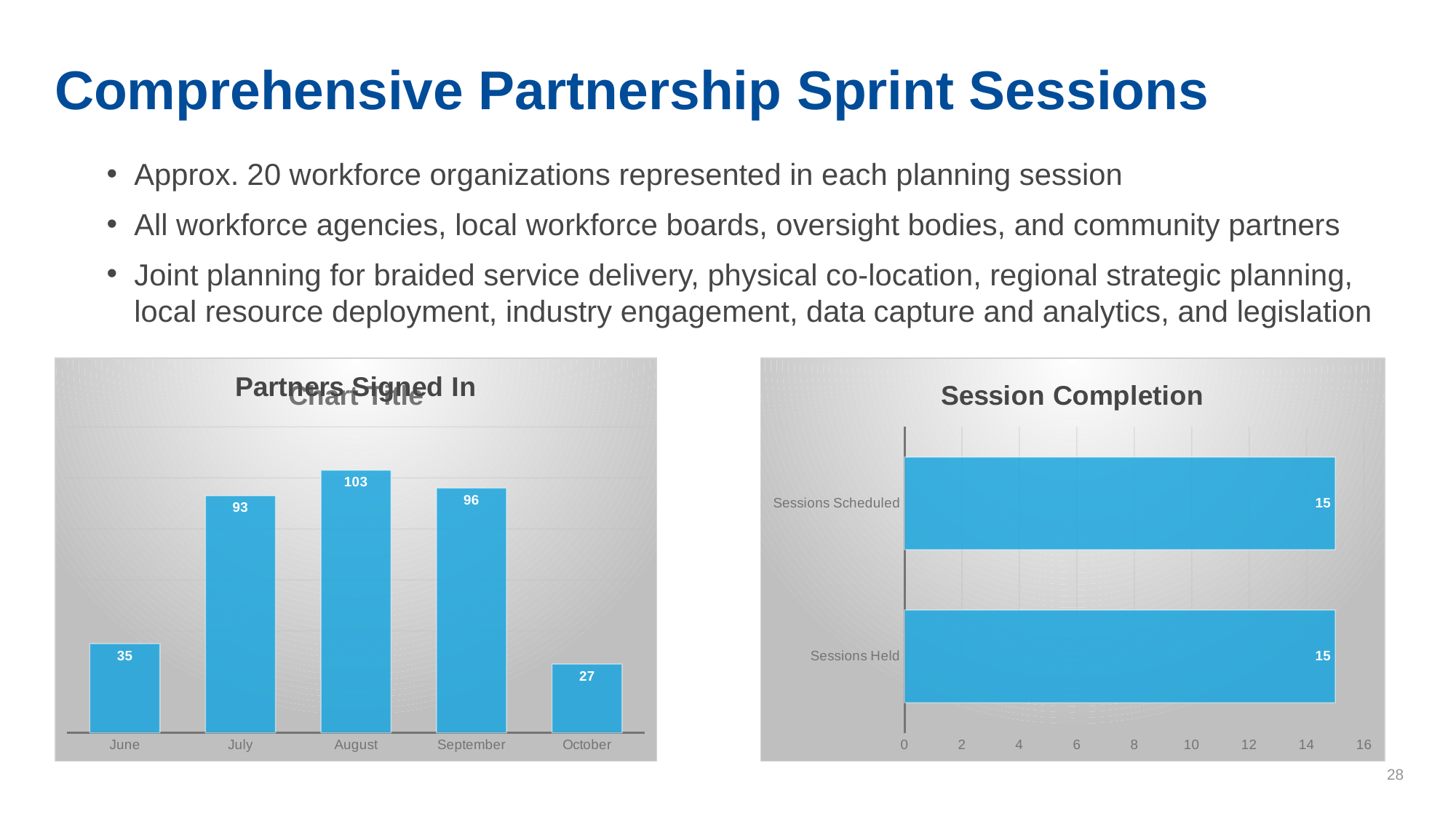
In the Session Completion chart, what is the value for Sessions Held? 15 In the Partners Signed In chart, what is the difference between the values for August and September? 7 In the Partners Signed In chart, what is the value for August? 103 In the Partners Signed In chart, which month has the lowest value? October How many categories are shown in the Session Completion chart? 2 In the Session Completion chart, is the value for Sessions Scheduled greater or less than 10? greater In the Session Completion chart, what is the difference between Sessions Scheduled and Sessions Held? 0 In the Partners Signed In chart, which is larger, the value for July or the value for September? September In the Partners Signed In chart, which month has the highest value? August What kind of chart is the Partners Signed In chart? Bar chart In the Partners Signed In chart, what is the value for June? 35 How many months are shown in the Partners Signed In chart? 5